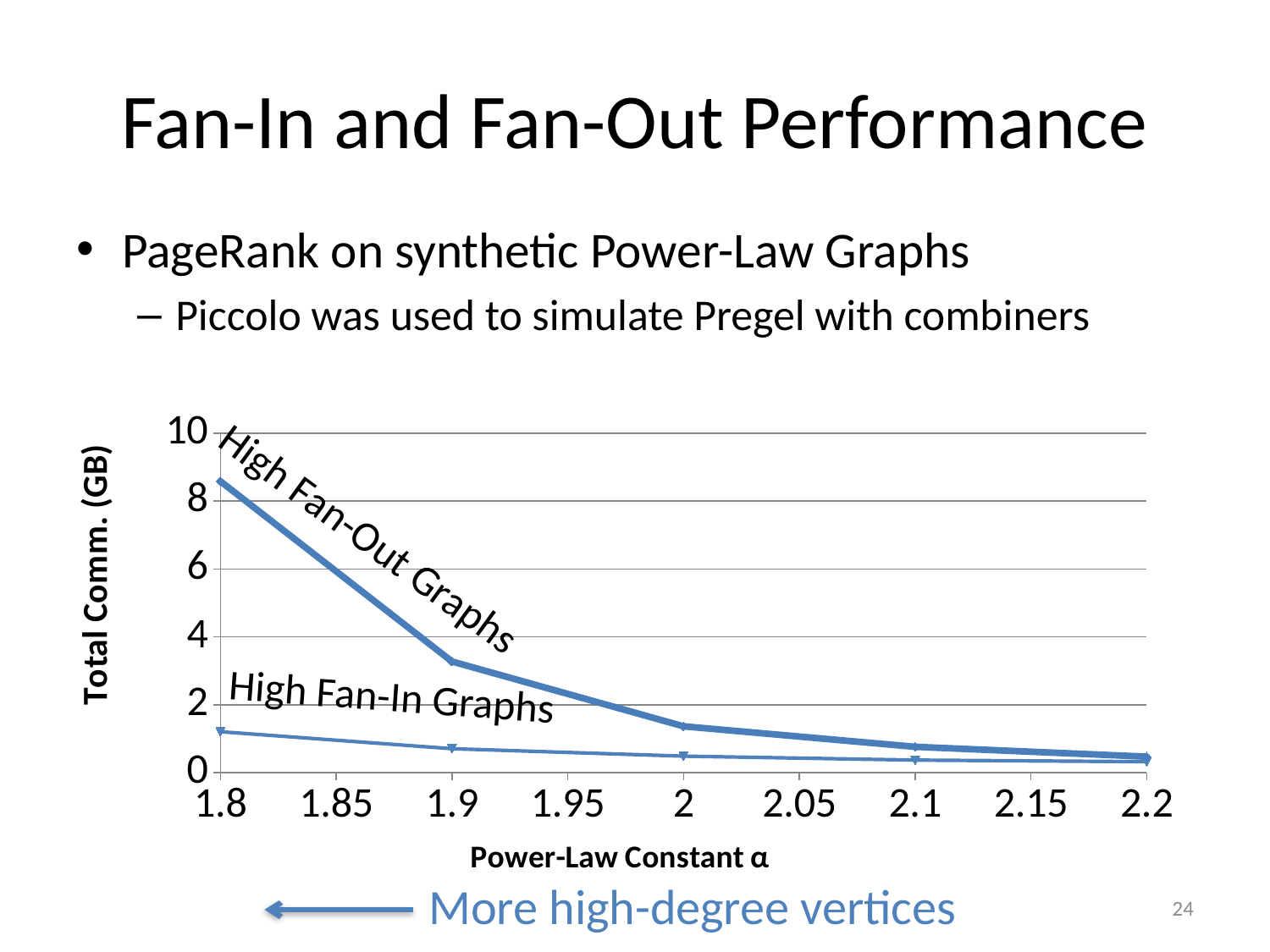
Is the value for High Fan-In Graphs at α = 1.8 greater or less than 2? less How many data series are plotted in the chart? 2 How many data points does the High Fan-Out Graphs line have? 5 Does the High Fan-Out Graphs line rise or fall as the Power-Law Constant α increases? fall What kind of chart is shown on the slide? line chart What is the label of the x axis of the chart? Power-Law Constant α Is the value for High Fan-Out Graphs at α = 1.8 greater or less than 8? greater Is the value for High Fan-Out Graphs at α = 1.9 greater or less than 4? less Does the High Fan-In Graphs line rise or fall as α increases from 1.8 to 2.2? fall What is the label of the y axis of the chart? Total Comm. (GB) At α = 1.8, which series has the larger total communication: High Fan-Out Graphs or High Fan-In Graphs? High Fan-Out Graphs